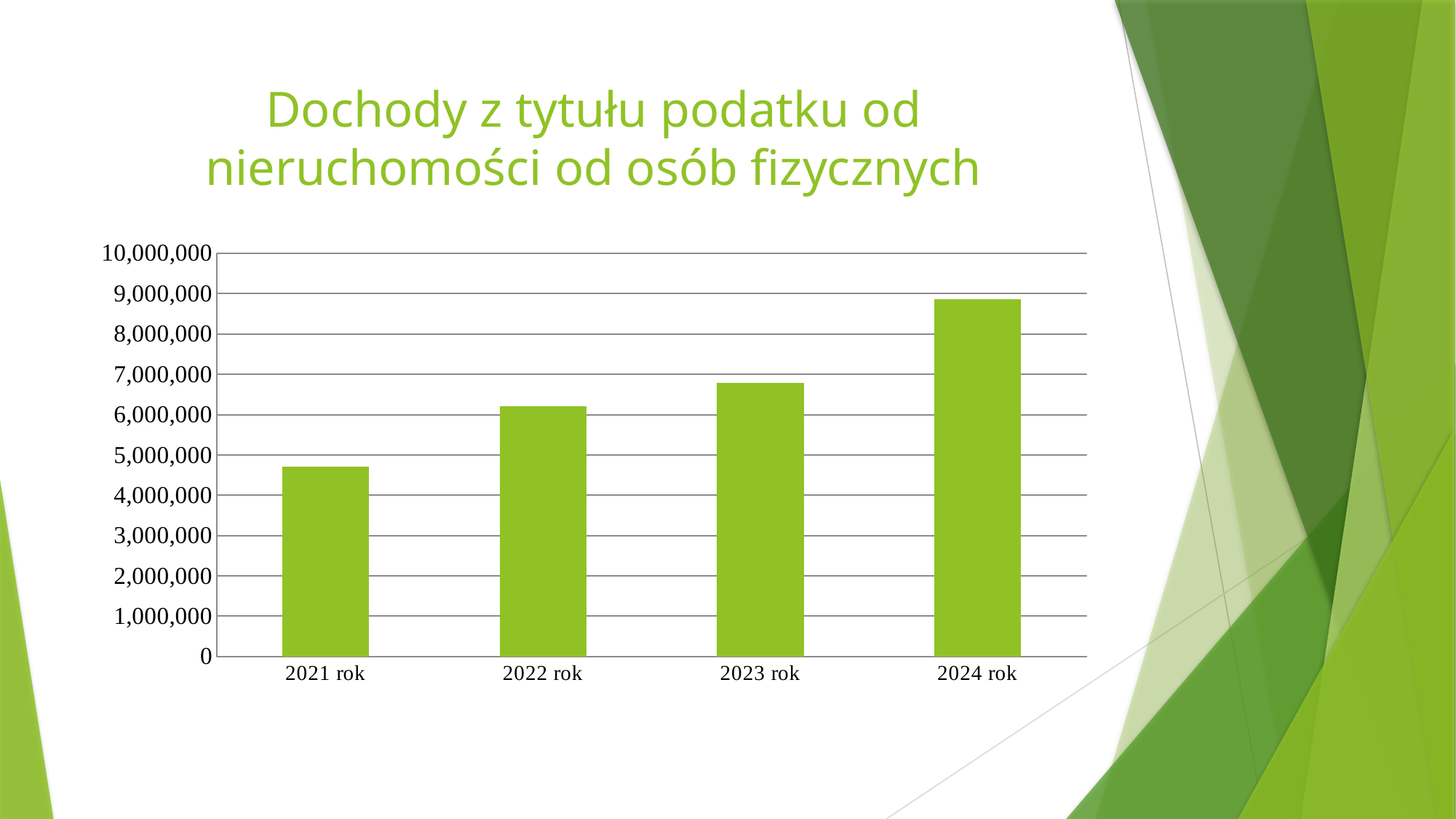
How many years (categories) are shown on the x axis? 4 Do the values rise or fall from 2021 rok to 2024 rok? rise Is the value for 2021 rok greater or less than 4,000,000? greater Is the value for 2021 rok greater or less than 5,000,000? less What kind of chart is shown on the slide? bar chart What is the title of the chart on the slide? Dochody z tytułu podatku od nieruchomości od osób fizycznych Is the value for 2024 rok greater or less than 8,000,000? greater Which year has the highest value? 2024 rok Which year has the lowest value? 2021 rok Which is larger, the value for 2022 rok or the value for 2024 rok? 2024 rok